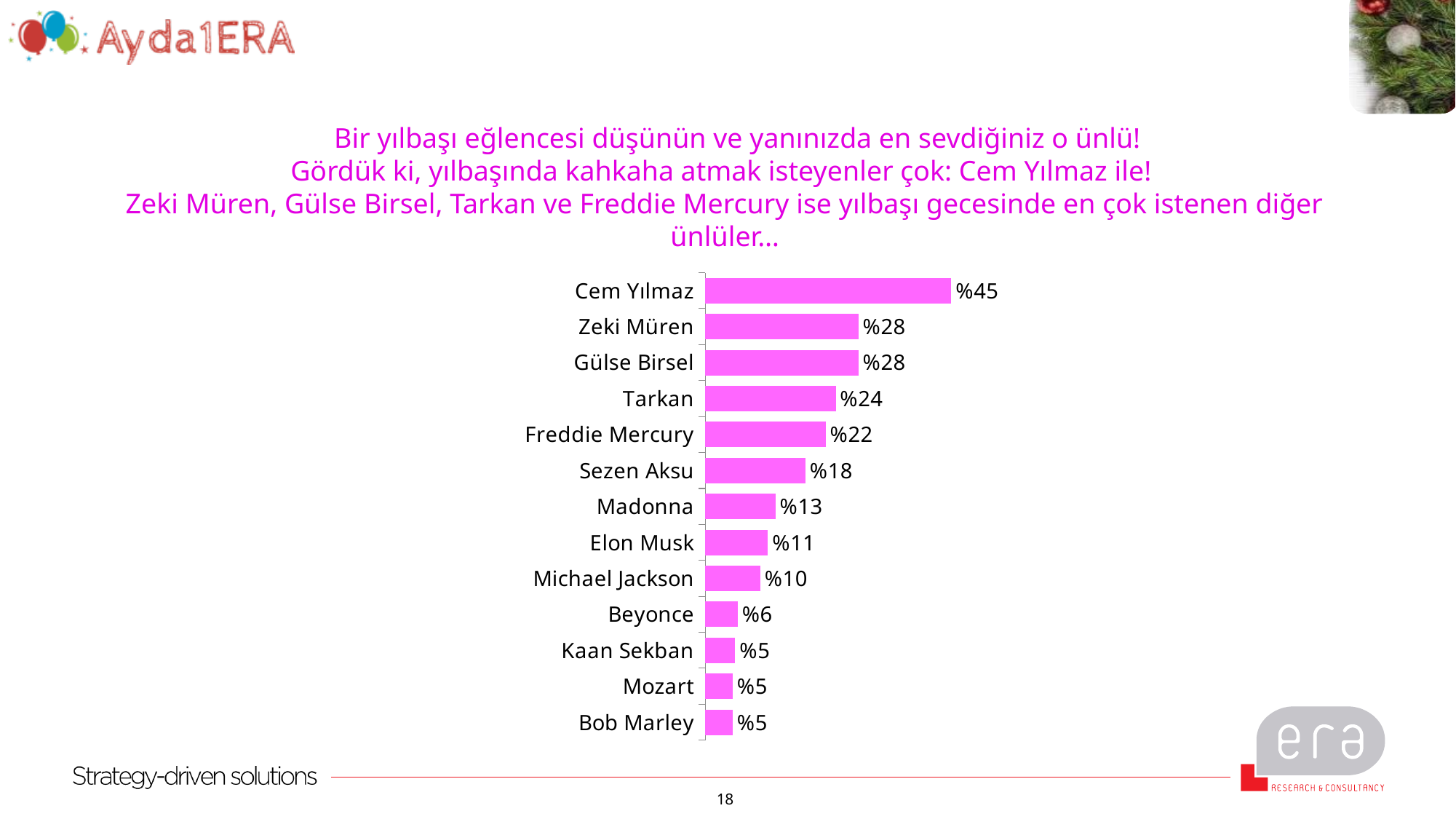
How many celebrities are shown in the chart? 13 Which is larger, the value for Tarkan or the value for Sezen Aksu? Tarkan What is the value for Freddie Mercury? %22 Which celebrity has the highest value? Cem Yılmaz What is the value for Sezen Aksu? %18 What is the difference between the values for Cem Yılmaz and Zeki Müren? %17 Which is larger, the value for Elon Musk or the value for Beyonce? Elon Musk What is the difference between the values for Tarkan and Madonna? %11 What is the value for Cem Yılmaz? %45 What is the value for Michael Jackson? %10 What colour are the bars in the chart? Pink What kind of chart is shown on the slide? Bar chart